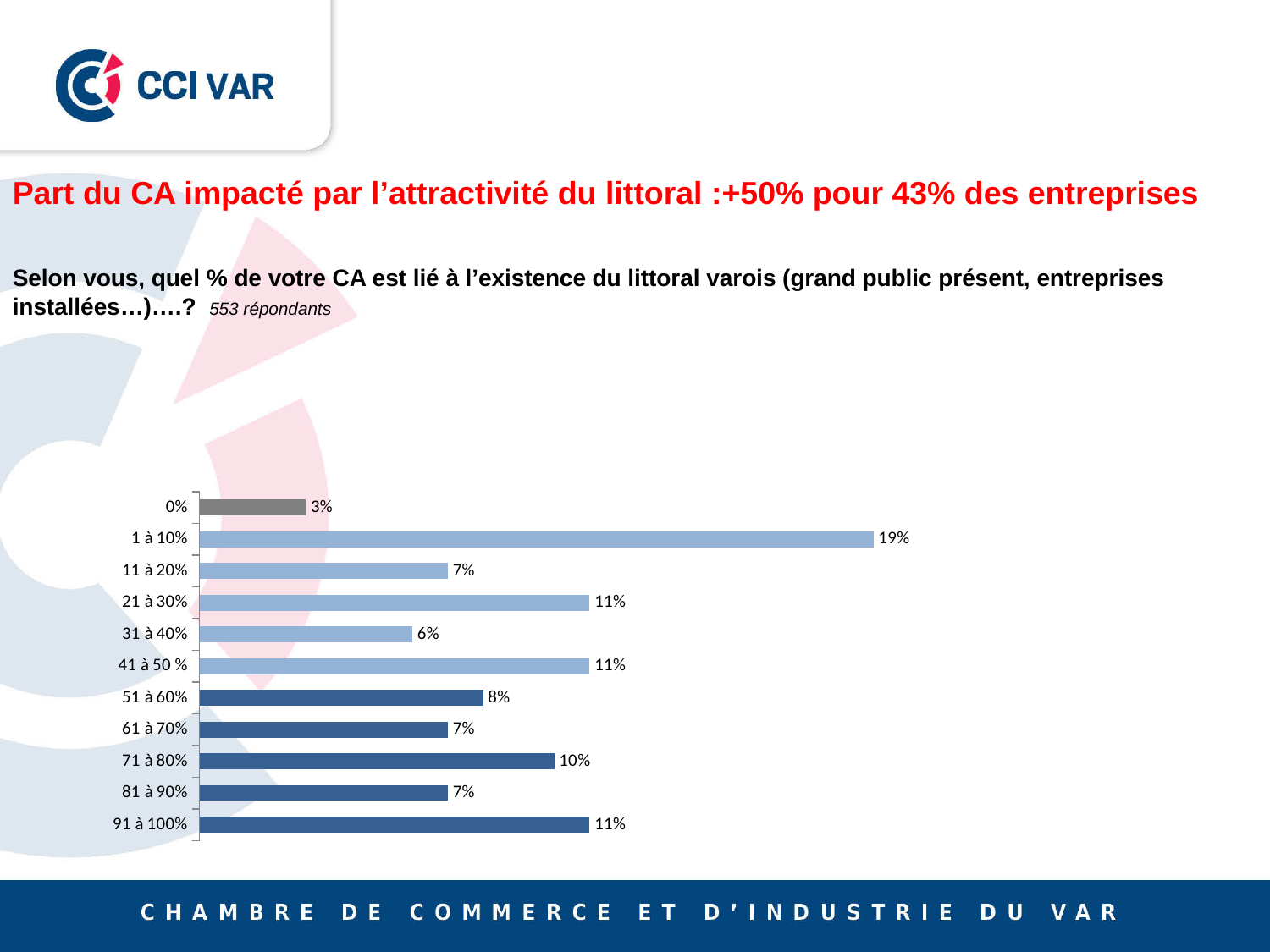
How many respondents does the slide say answered the question? 553 répondants Which category has the highest value? 1 à 10% Which category has the lowest value? 0% What is the value for the '1 à 10%' category? 19% What is the value for the '71 à 80%' category? 10% Which is larger, the value for '71 à 80%' or the value for '61 à 70%'? 71 à 80% What is the value for the '0%' category? 3% What is the difference between the values for '1 à 10%' and '51 à 60%'? 11% What kind of chart is shown on the slide? Bar chart How many categories are shown in the chart? 11 What is the difference between the values for '21 à 30%' and '31 à 40%'? 5% What is the value for the '31 à 40%' category? 6%